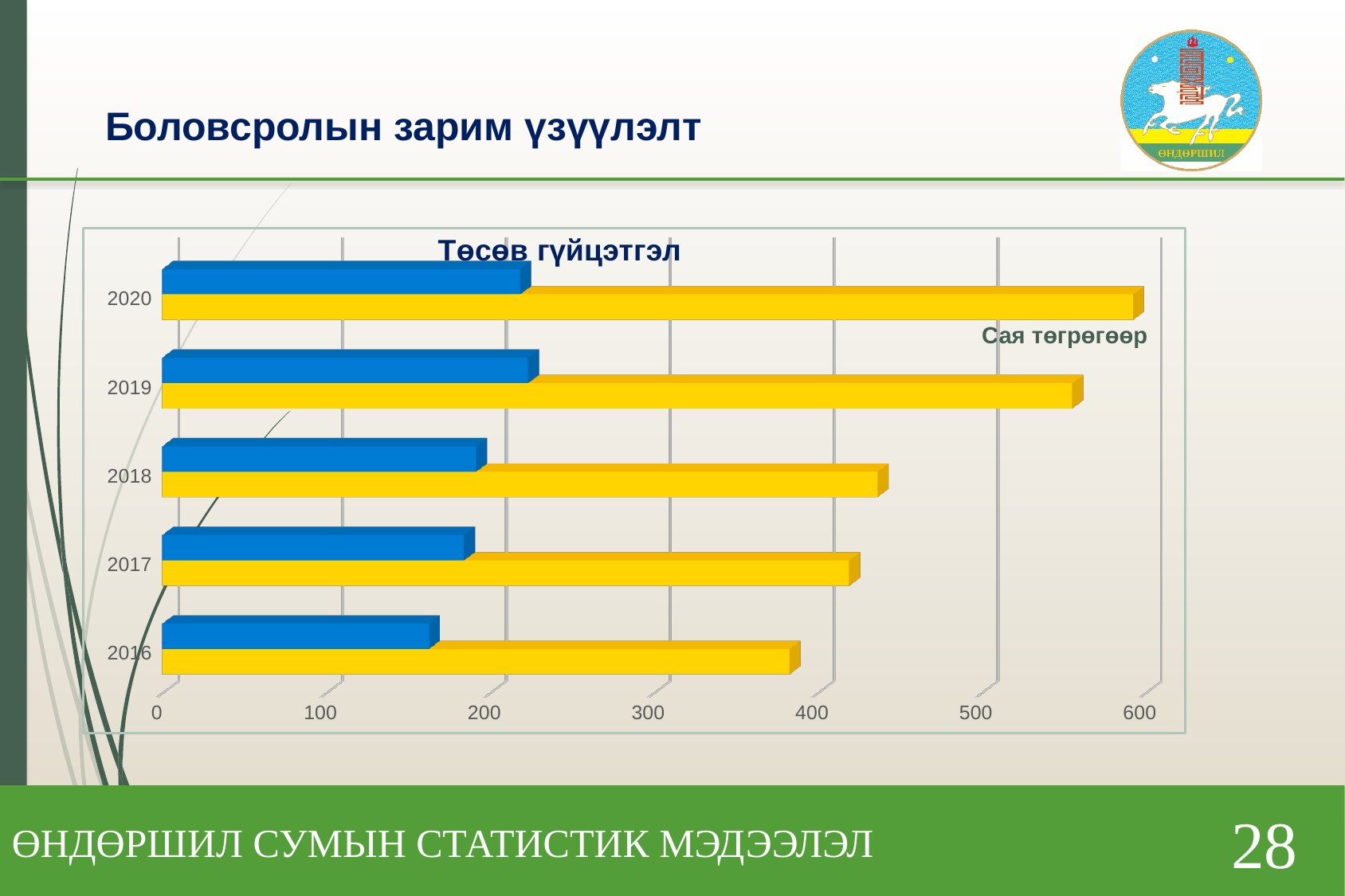
Which is larger, the yellow bar for 2020 or the yellow bar for 2019? 2020 How many years (categories) are shown on the chart? 5 Is the yellow bar for 2020 greater or less than 500? greater Which year has the shortest blue bar? 2016 Which year has the shortest yellow bar? 2016 What unit note is printed on the chart near the top right? Сая төгрөгөөр Is the yellow bar for 2016 greater or less than 300? greater Which year has the longest yellow bar? 2020 What is the title of the chart? Төсөв гүйцэтгэл Do the yellow bars rise or fall from 2016 to 2020? rise Is the blue bar for 2016 greater or less than 200? less What kind of chart is shown on the slide? bar chart